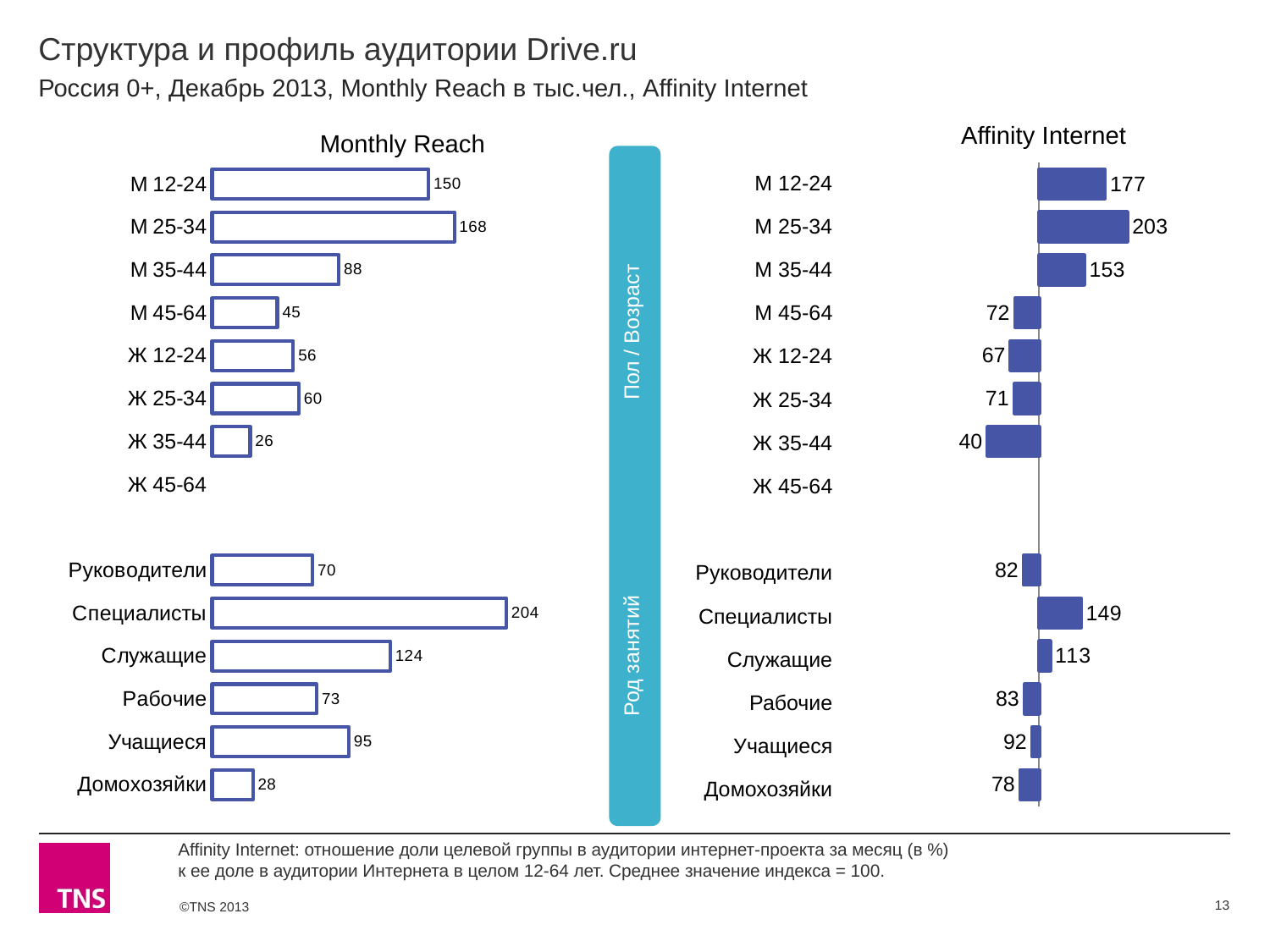
In the Monthly Reach chart, which occupation category (Род занятий) has the highest value? Специалисты In the Monthly Reach chart, what is the difference between the values for М 25-34 and М 12-24? 18 What is the title of the chart on the right side of the slide? Affinity Internet In the Monthly Reach chart, what is the value for М 25-34? 168 In the Affinity Internet chart, what is the value for Специалисты? 149 What kind of chart is the Monthly Reach chart? Bar chart In the Affinity Internet chart, which is larger: the value for Служащие or for Учащиеся? Служащие In the Monthly Reach chart, how many occupation (Род занятий) categories are listed? 6 In the Affinity Internet chart, which category has the highest value? М 25-34 In the Affinity Internet chart, what is the difference between the values for М 25-34 and М 35-44? 50 In the Affinity Internet chart, which category has the lowest labelled value? Ж 35-44 In the Monthly Reach chart, what is the value for Домохозяйки? 28